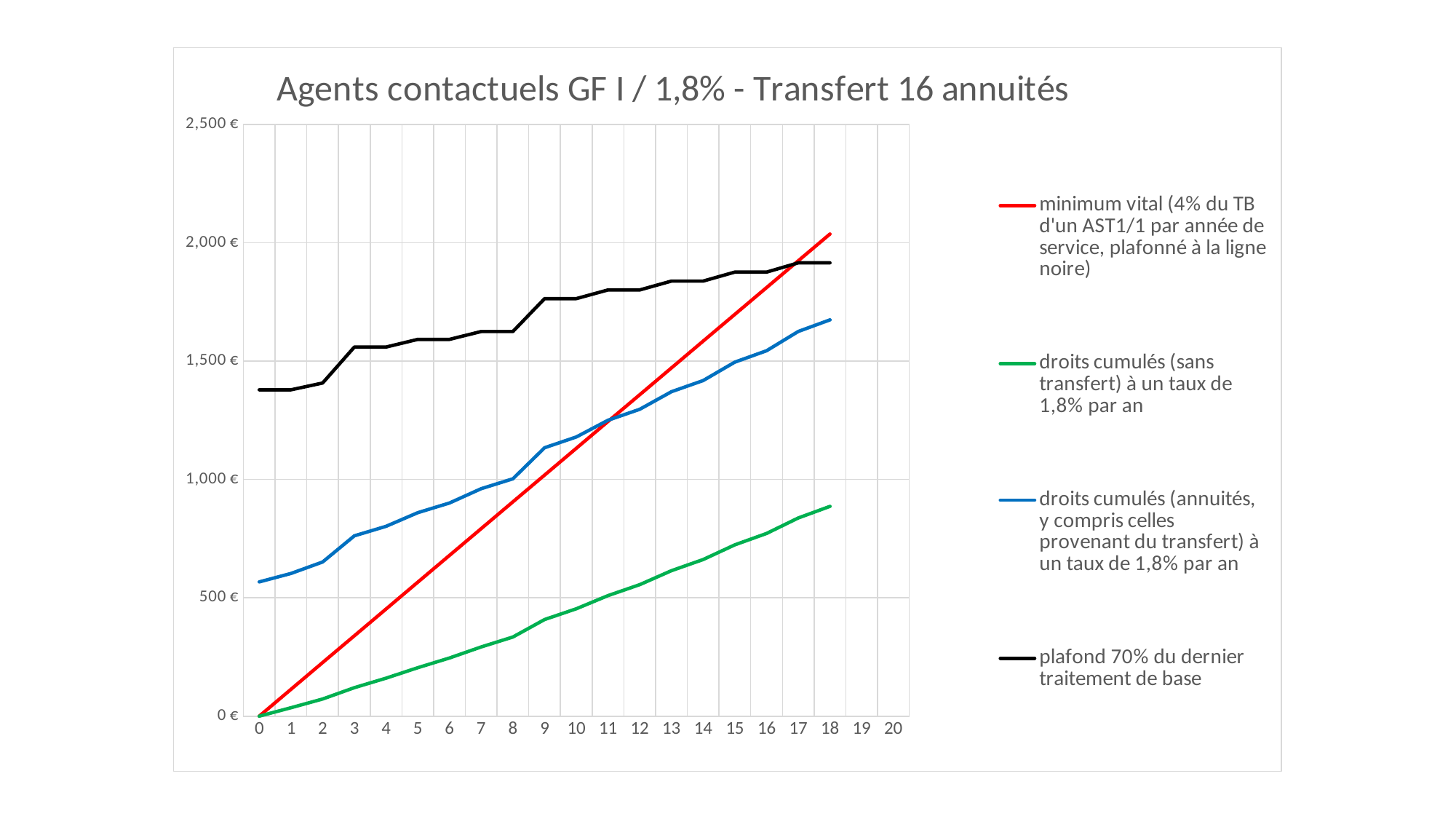
Is the value of the blue 'droits cumulés (annuités...)' line at x = 18 greater or less than 1,500 €? greater What is the value of the red 'minimum vital' line at x = 0? 0 € Does the red 'minimum vital' line rise or fall as the x axis increases from 0 to 18? rises Is the value of the green 'droits cumulés (sans transfert)' line at x = 18 greater or less than 1,000 €? less What kind of chart is shown on the slide? line chart How many series does the legend list? 4 What colour is the line for 'plafond 70% du dernier traitement de base'? black At x = 5, which is higher: the red 'minimum vital' line or the blue 'droits cumulés (annuités...)' line? the blue line At x = 18, which series has the lowest value? droits cumulés (sans transfert) à un taux de 1,8% par an What is the title of the chart? Agents contactuels GF I / 1,8% - Transfert 16 annuités At x = 18, which series has the highest value? minimum vital (4% du TB d'un AST1/1 par année de service, plafonné à la ligne noire) Is the value of the black 'plafond 70%' line at x = 0 greater or less than 1,000 €? greater